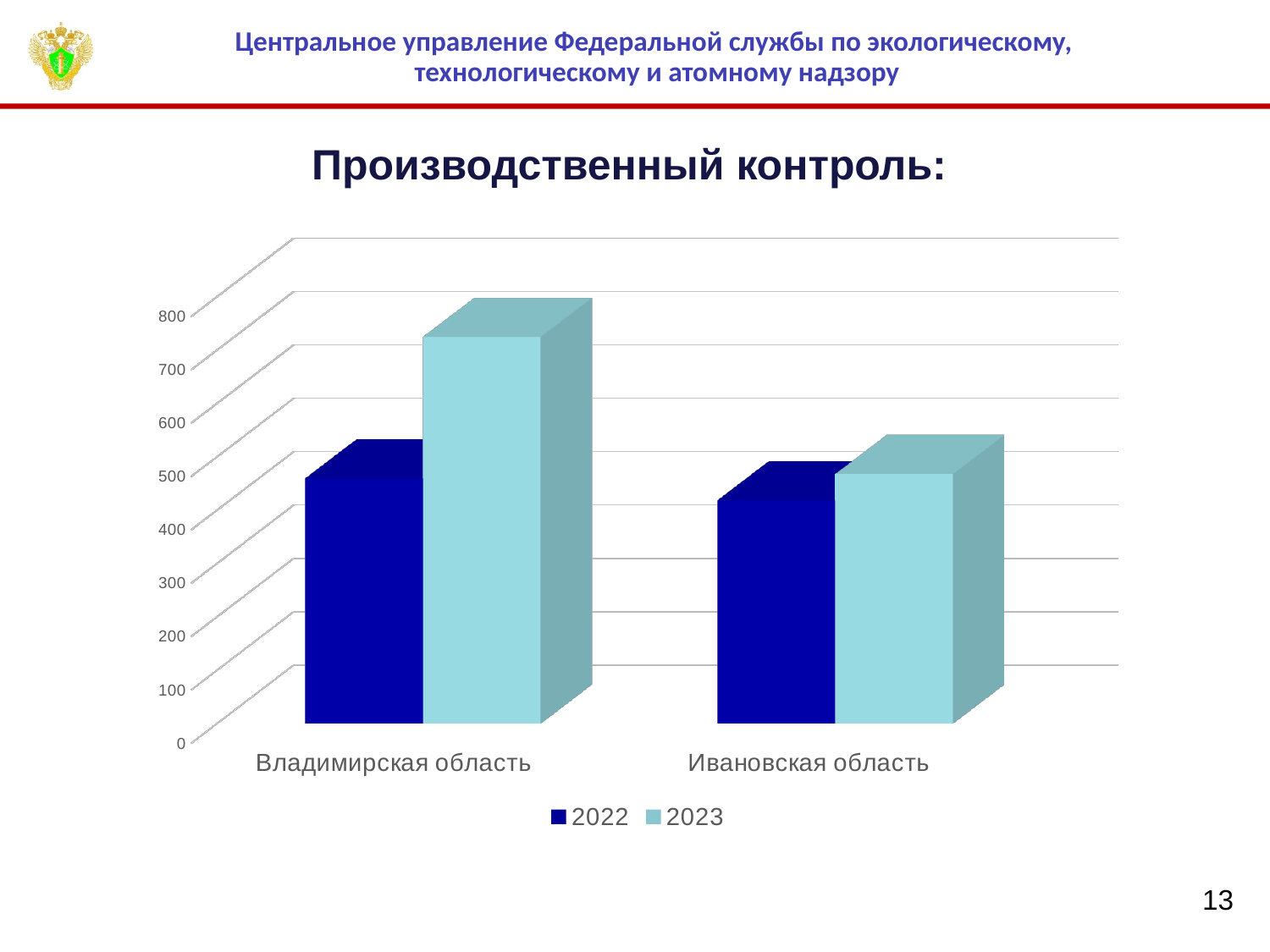
Does the 2023 series rise or fall from Владимирская область to Ивановская область? fall Which category has the lowest 2022 value? Ивановская область Which series does the dark blue colour represent in the legend? 2022 Is the 2023 value for Владимирская область greater or less than 700? greater What is the title of the chart? Производственный контроль: Is the 2022 value for Ивановская область greater or less than 500? less How many categories are shown on the x axis? 2 For Владимирская область, which is larger: the 2022 value or the 2023 value? 2023 For Ивановская область, which is larger: the 2022 value or the 2023 value? 2023 Which category has the highest 2023 value? Владимирская область How many series does the legend list? 2 What kind of chart is shown on the slide? bar chart